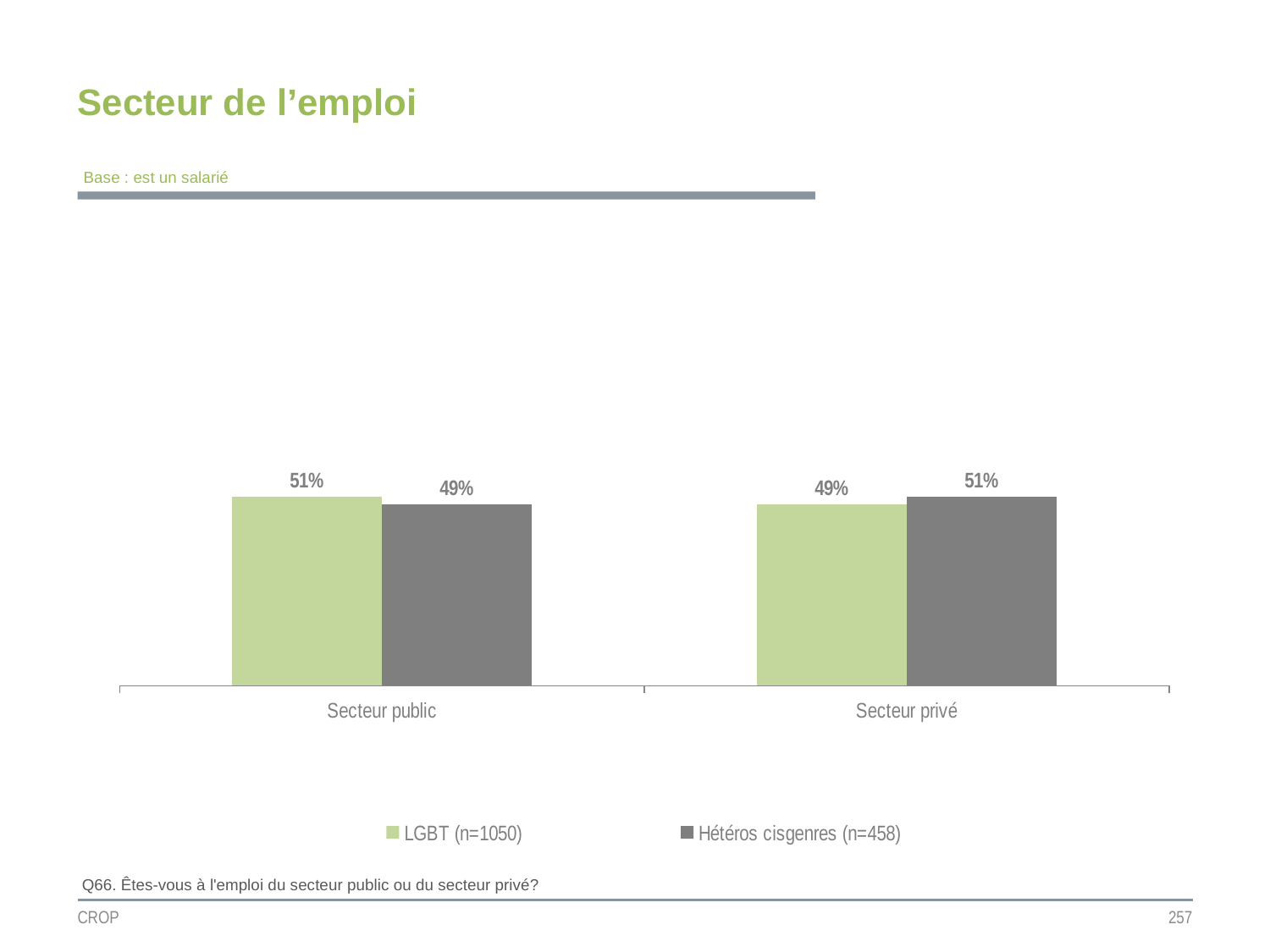
What kind of chart is shown on the slide? Bar chart How many categories are shown on the x axis of the chart? 2 What is the value for LGBT (n=1050) in Secteur privé? 49% What is the value for Hétéros cisgenres (n=458) in Secteur privé? 51% What is the difference between the Hétéros cisgenres (n=458) and LGBT (n=1050) values in Secteur privé? 2% What is the value for LGBT (n=1050) in Secteur public? 51% Which series has the higher value in Secteur public, LGBT (n=1050) or Hétéros cisgenres (n=458)? LGBT (n=1050) How many series does the legend list? 2 What is the value for Hétéros cisgenres (n=458) in Secteur public? 49% Which series has the higher value in Secteur privé, LGBT (n=1050) or Hétéros cisgenres (n=458)? Hétéros cisgenres (n=458) Which series is shown in green in the legend? LGBT (n=1050) What is the difference between the LGBT (n=1050) and Hétéros cisgenres (n=458) values in Secteur public? 2%